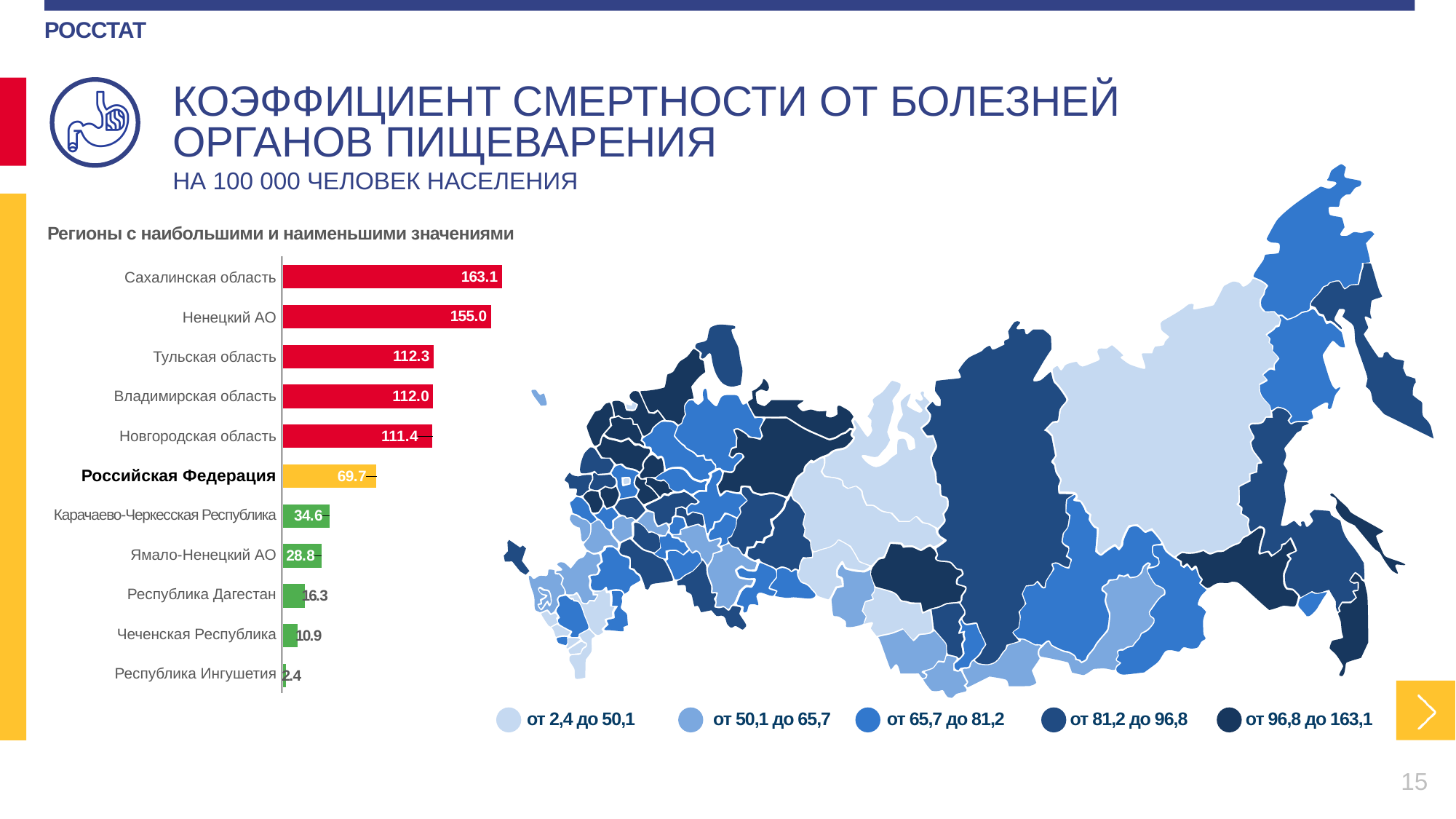
How many value ranges does the map legend list? 5 How many bars are shown in the bar chart? 11 In the bar chart, what is the difference between the values for Сахалинская область and Ненецкий АО? 8.1 In the bar chart, what is the value for Сахалинская область? 163.1 What kind of chart is shown on the left of the slide? bar chart In the bar chart, which has the larger value: Тульская область or Владимирская область? Тульская область In the bar chart, which has the larger value: Ямало-Ненецкий АО or Чеченская Республика? Ямало-Ненецкий АО In the bar chart, what is the value for Республика Дагестан? 16.3 In the bar chart, what is the value for Российская Федерация? 69.7 In the bar chart, which region has the lowest value? Республика Ингушетия In the bar chart, what is the difference between the values for Российская Федерация and Карачаево-Черкесская Республика? 35.1 In the bar chart, which region has the highest value? Сахалинская область